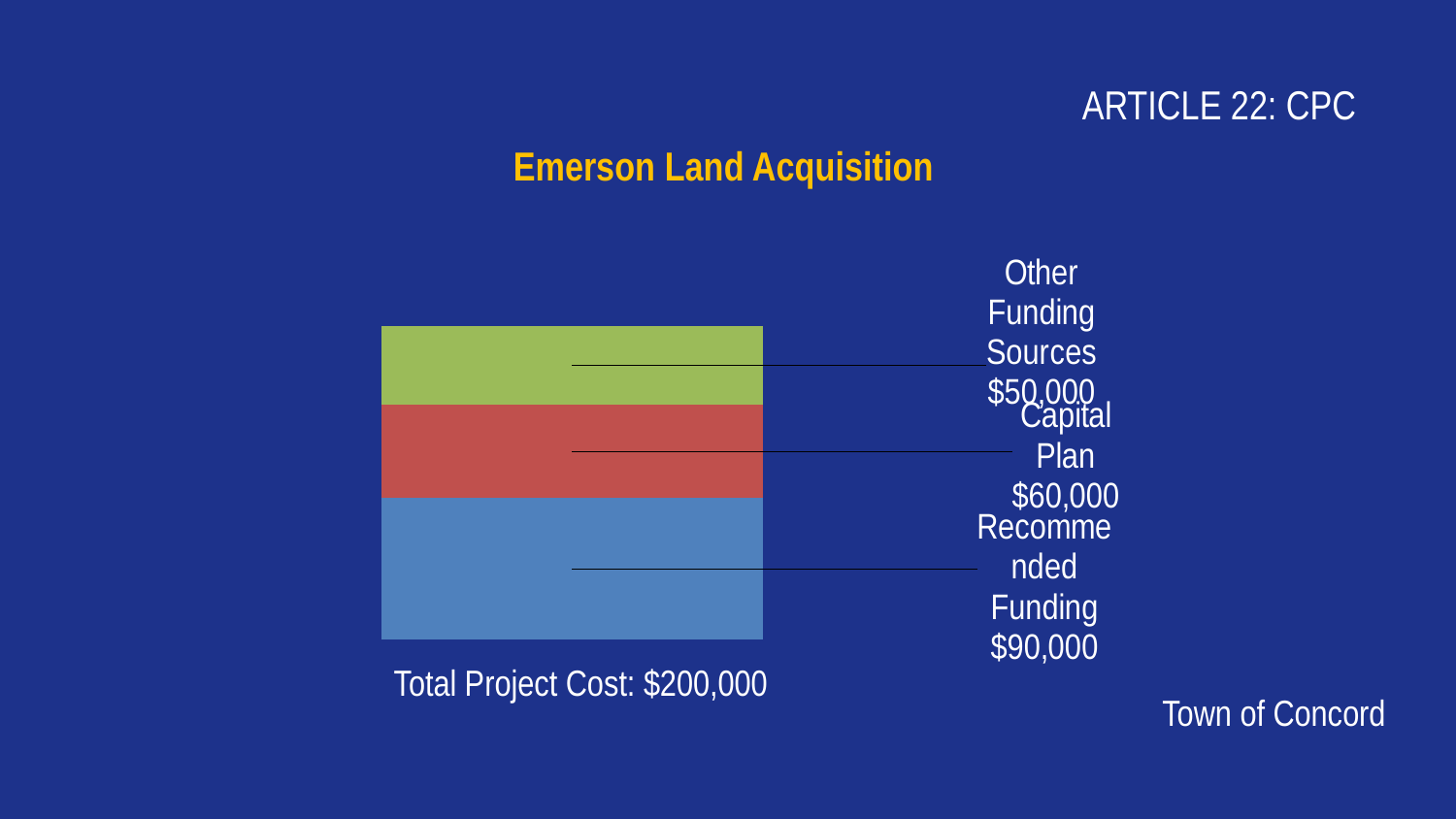
Which segment of the stacked bar has the largest value? Recommended Funding How many segments make up the stacked bar? 3 What is the title of the chart? Emerson Land Acquisition Which is larger, Capital Plan or Other Funding Sources? Capital Plan What is the difference between the Recommended Funding and Capital Plan values? $30,000 What is the value of the Other Funding Sources segment? $50,000 What is the difference between the Capital Plan and Other Funding Sources values? $10,000 What is the value of the Capital Plan segment? $60,000 What kind of chart is shown on the slide? Stacked bar chart Which segment of the stacked bar has the smallest value? Other Funding Sources What is the total of the stacked bar? $200,000 What is the value of the Recommended Funding segment? $90,000